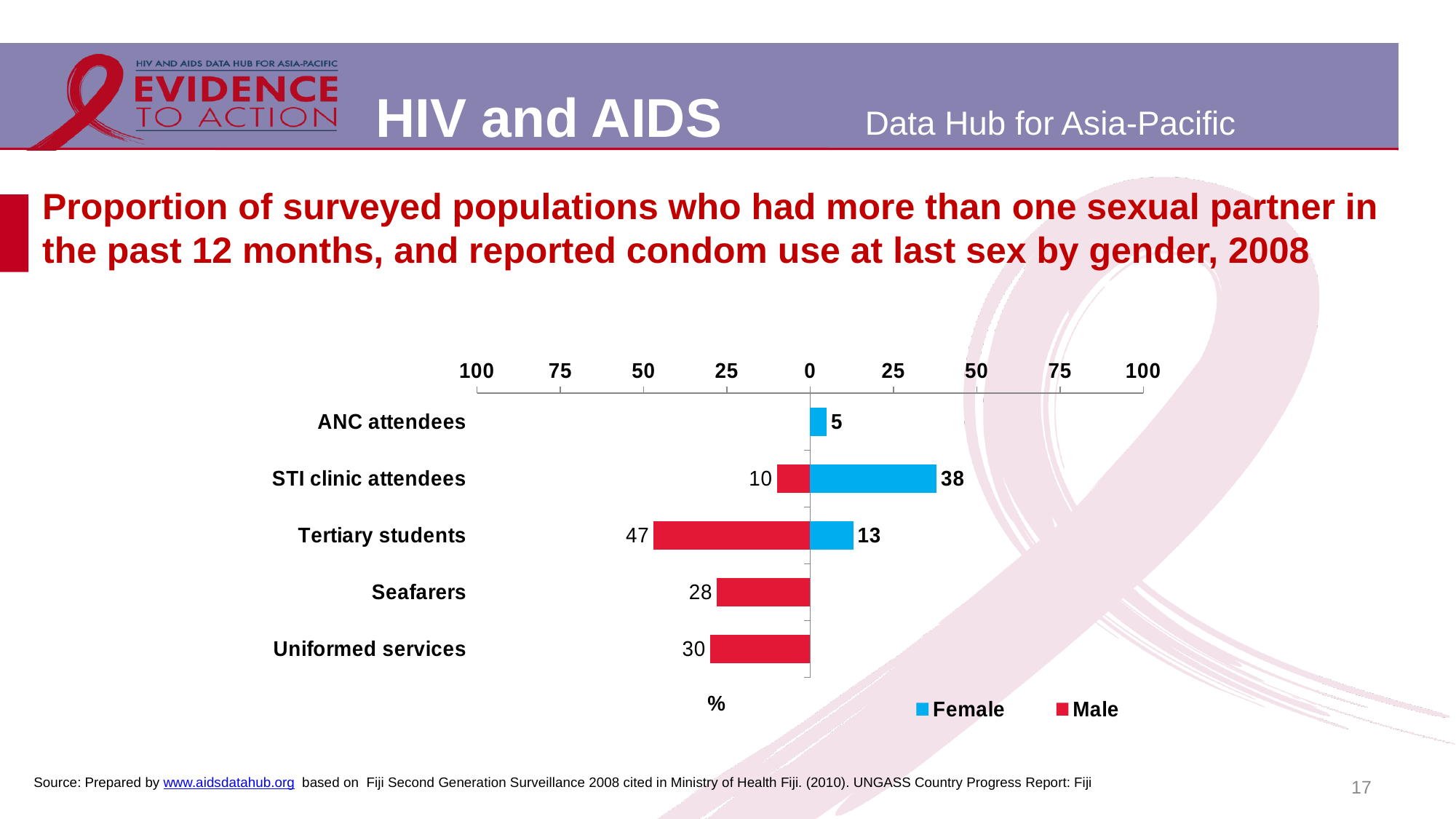
What is the Male value for Uniformed services? 30 How many surveyed population categories are shown on the chart? 5 Which category has the highest Male value? Tertiary students What kind of chart is shown on the slide? Bar chart Is the Male value for Seafarers greater or less than 25? greater Which category has the lowest Female value among those with a Female bar? ANC attendees What is the Male value for Tertiary students? 47 For STI clinic attendees, which is larger, the Female value or the Male value? Female What is the Female value for STI clinic attendees? 38 How many series does the legend list? 2 What is the difference between the Male and Female values for Tertiary students? 34 What is the Female value for ANC attendees? 5